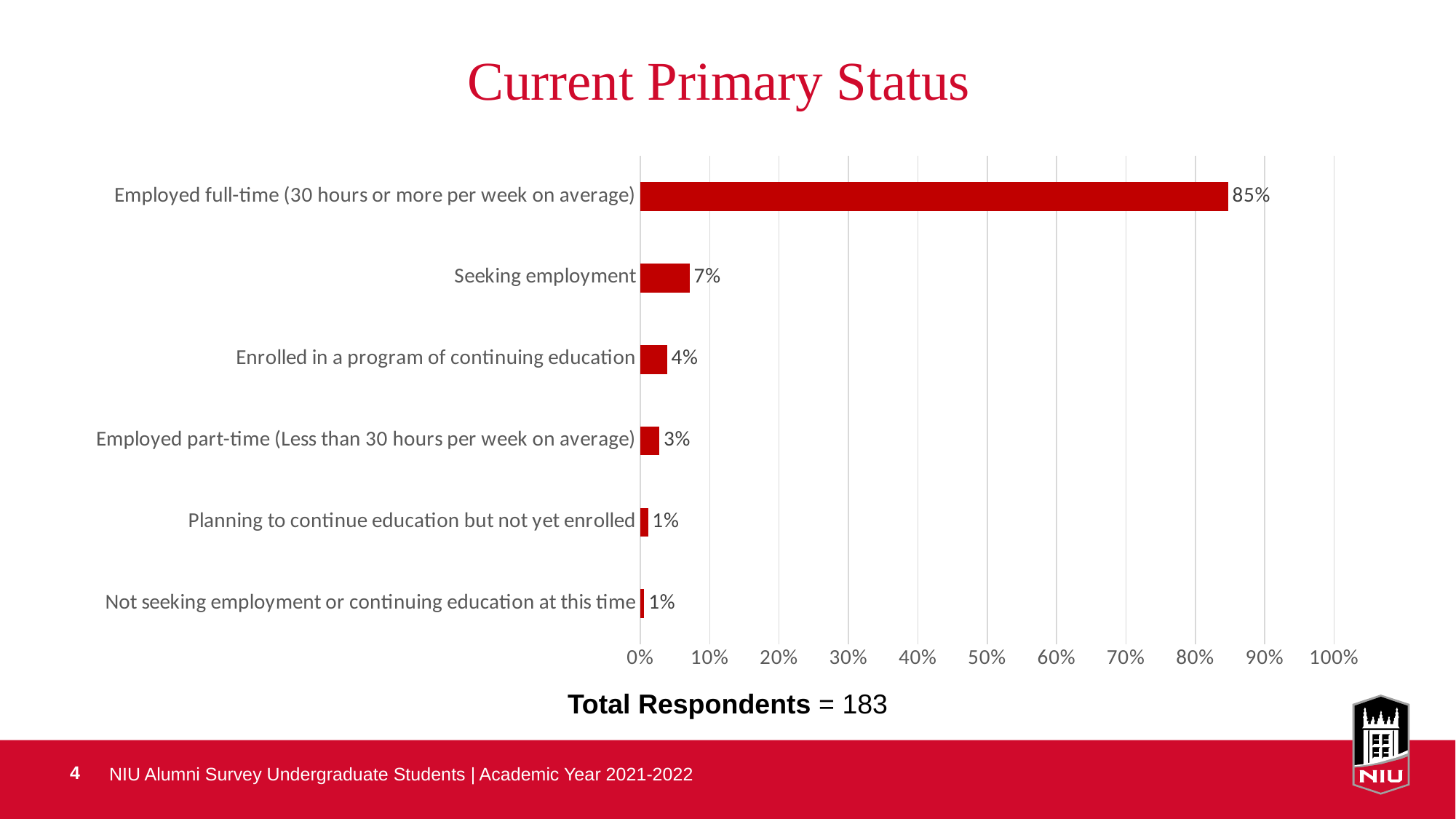
What percentage of respondents are enrolled in a program of continuing education? 4% Is the value for 'Employed full-time' greater or less than 80%? greater Which is larger: the value for 'Enrolled in a program of continuing education' or 'Employed part-time'? Enrolled in a program of continuing education What percentage of respondents are seeking employment? 7% How many categories are shown in the chart? 6 What type of chart is shown on the slide? Bar chart Which category has the highest percentage? Employed full-time (30 hours or more per week on average) What is the total number of respondents stated below the chart? 183 What percentage of respondents are employed full-time (30 hours or more per week on average)? 85% What percentage of respondents are employed part-time (less than 30 hours per week on average)? 3% What is the difference in percentage points between 'Seeking employment' and 'Enrolled in a program of continuing education'? 3 What is the difference in percentage points between 'Employed full-time' and 'Seeking employment'? 78